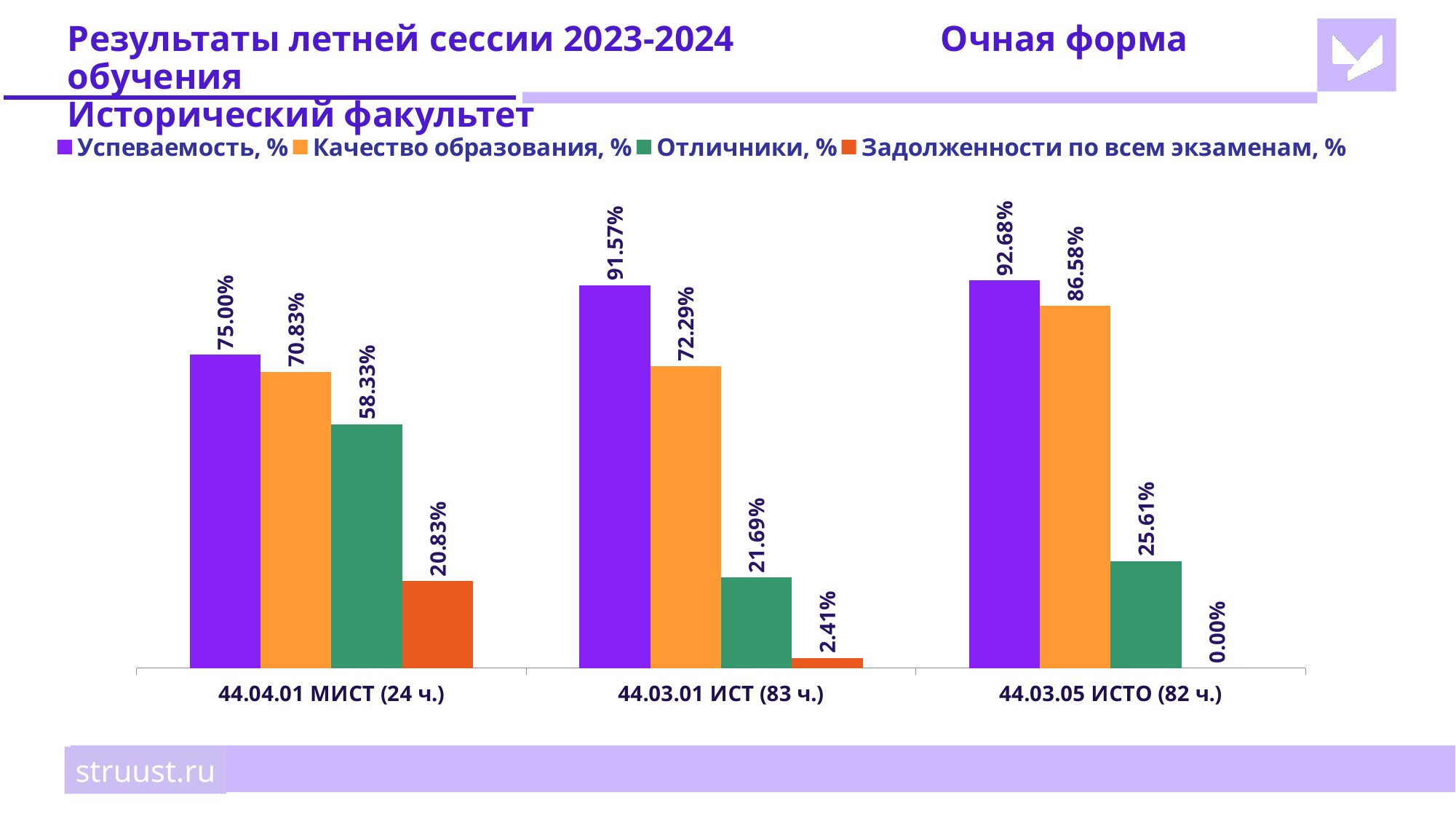
How many categories are shown on the x axis? 3 Which is larger: Отличники, % for 44.04.01 МИСТ (24 ч.) or Отличники, % for 44.03.05 ИСТО (82 ч.)? 44.04.01 МИСТ (24 ч.) What is the value of Отличники, % for 44.03.05 ИСТО (82 ч.)? 25.61% How many series does the legend list? 4 Which category has the lowest value of Отличники, %? 44.03.01 ИСТ (83 ч.) What is the value of Задолженности по всем экзаменам, % for 44.03.01 ИСТ (83 ч.)? 2.41% What kind of chart is shown on the slide? Bar chart What is the difference between Успеваемость, % and Качество образования, % for 44.03.05 ИСТО (82 ч.)? 6.10% What is the value of Качество образования, % for 44.04.01 МИСТ (24 ч.)? 70.83% What is the value of Успеваемость, % for 44.03.01 ИСТ (83 ч.)? 91.57% Which colour represents Задолженности по всем экзаменам, % in the legend? Orange-red Which category has the highest value of Успеваемость, %? 44.03.05 ИСТО (82 ч.)